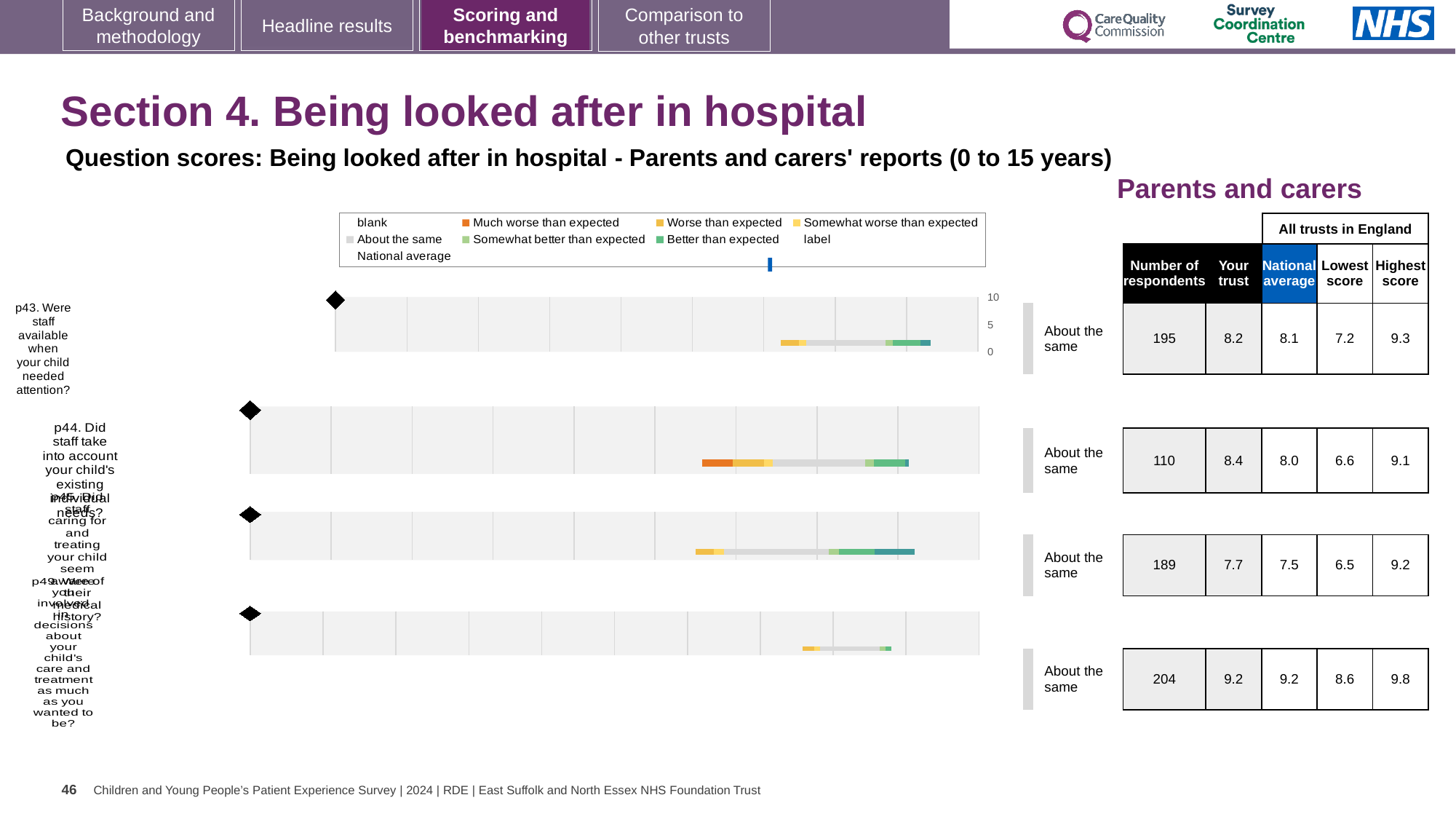
What benchmark category is shown for all four questions? About the same What is the highest score among all trusts in England for question p43? 9.3 What kind of chart is used to show the question scores? Bar chart What is the national average score for question p43? 8.1 How many questions are plotted on the chart? 4 Which question row has the highest 'Your trust' score? The bottom (fourth) row, 9.2 For question p43, what is the difference between the highest score (9.3) and the lowest score (7.2)? 2.1 How many respondents are shown for the bottom (fourth) question row? 204 What is the lowest score among all trusts in England for the second question row? 6.6 For question p43, which is larger: the 'Your trust' score or the national average? Your trust (8.2) What is the 'Your trust' score for question p43? 8.2 How many respondents are shown for question p43 (Were staff available when your child needed attention?)? 195